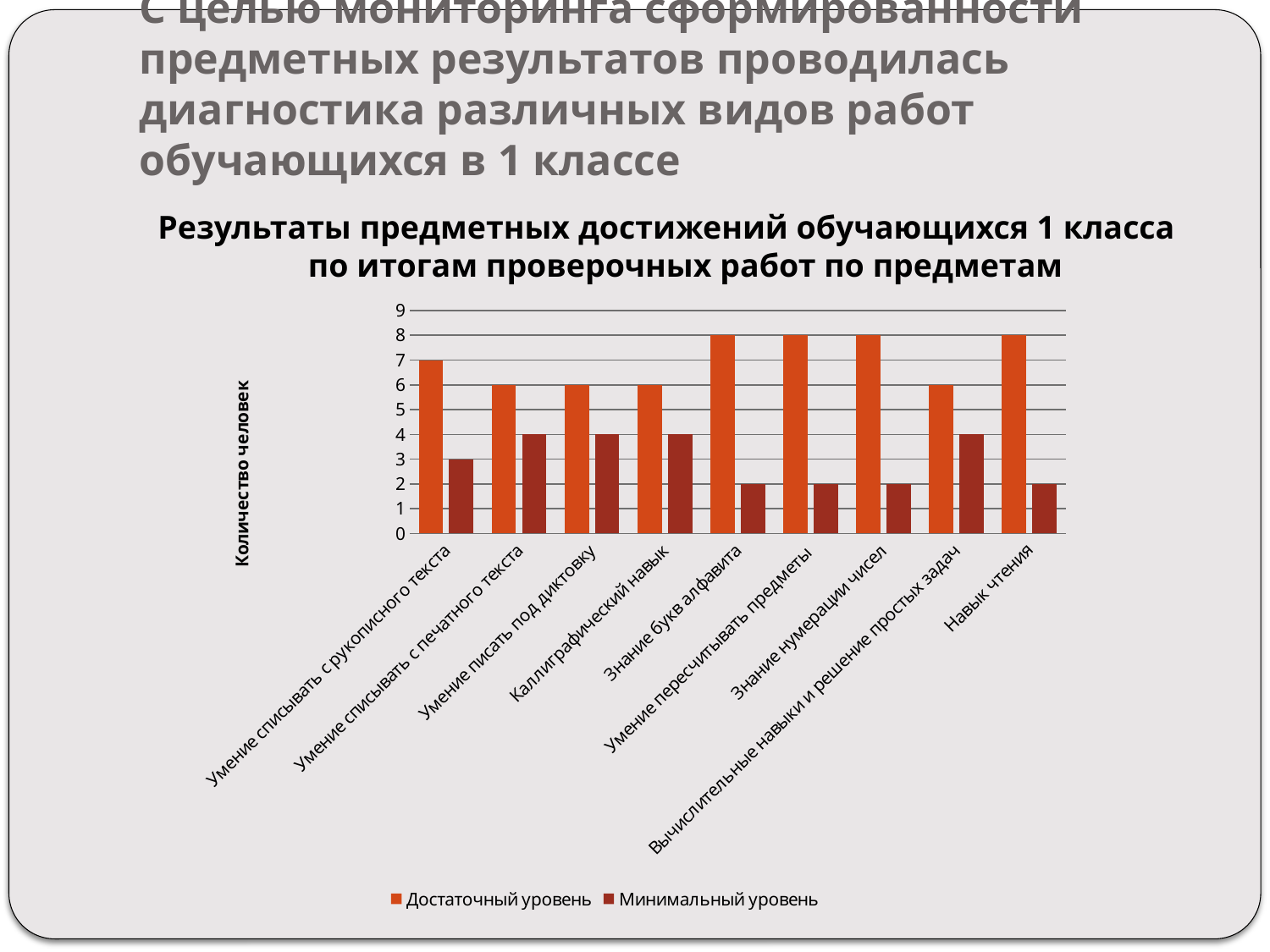
What is the value of Минимальный уровень for Умение списывать с рукописного текста? 3 What is the value of Минимальный уровень for Каллиграфический навык? 4 What is the label of the vertical axis? Количество человек What is the value of Достаточный уровень for Знание букв алфавита? 8 What is the value of Достаточный уровень for Вычислительные навыки и решение простых задач? 6 Which is larger for Умение пересчитывать предметы: Достаточный уровень or Минимальный уровень? Достаточный уровень What is the difference between Достаточный уровень and Минимальный уровень for Умение писать под диктовку? 2 How many categories are shown on the x axis? 9 What is the value of Достаточный уровень for Умение списывать с рукописного текста? 7 How many series does the legend list? 2 What type of chart is shown on the slide? bar chart What is the difference between Достаточный уровень and Минимальный уровень for Навык чтения? 6